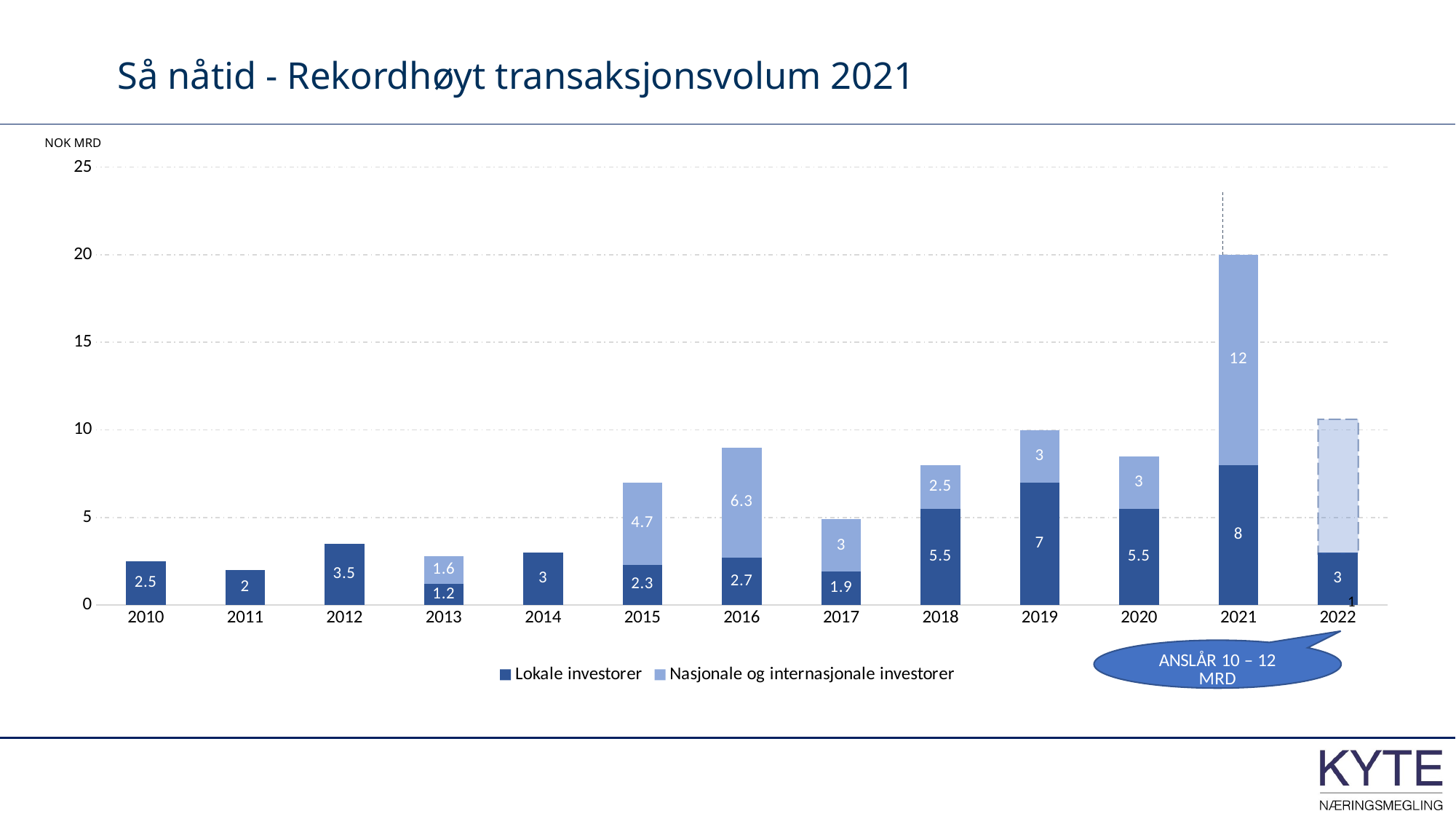
What is the total of the stacked bar for 2021? 20 What is the value for Nasjonale og internasjonale investorer in 2016? 6.3 What unit is shown on the y axis label? NOK MRD What type of chart is shown on the slide? stacked bar chart What is the difference between the Lokale investorer values for 2019 and 2020? 1.5 How many series does the legend list? 2 Which year has the highest value for Lokale investorer? 2021 What is the total of the stacked bar for 2015? 7 What is the value for Nasjonale og internasjonale investorer in 2021? 12 What is the value for Lokale investorer in 2019? 7 Which year has the lowest value for Lokale investorer? 2013 Which is larger: the Lokale investorer value for 2012 or for 2014? 2012